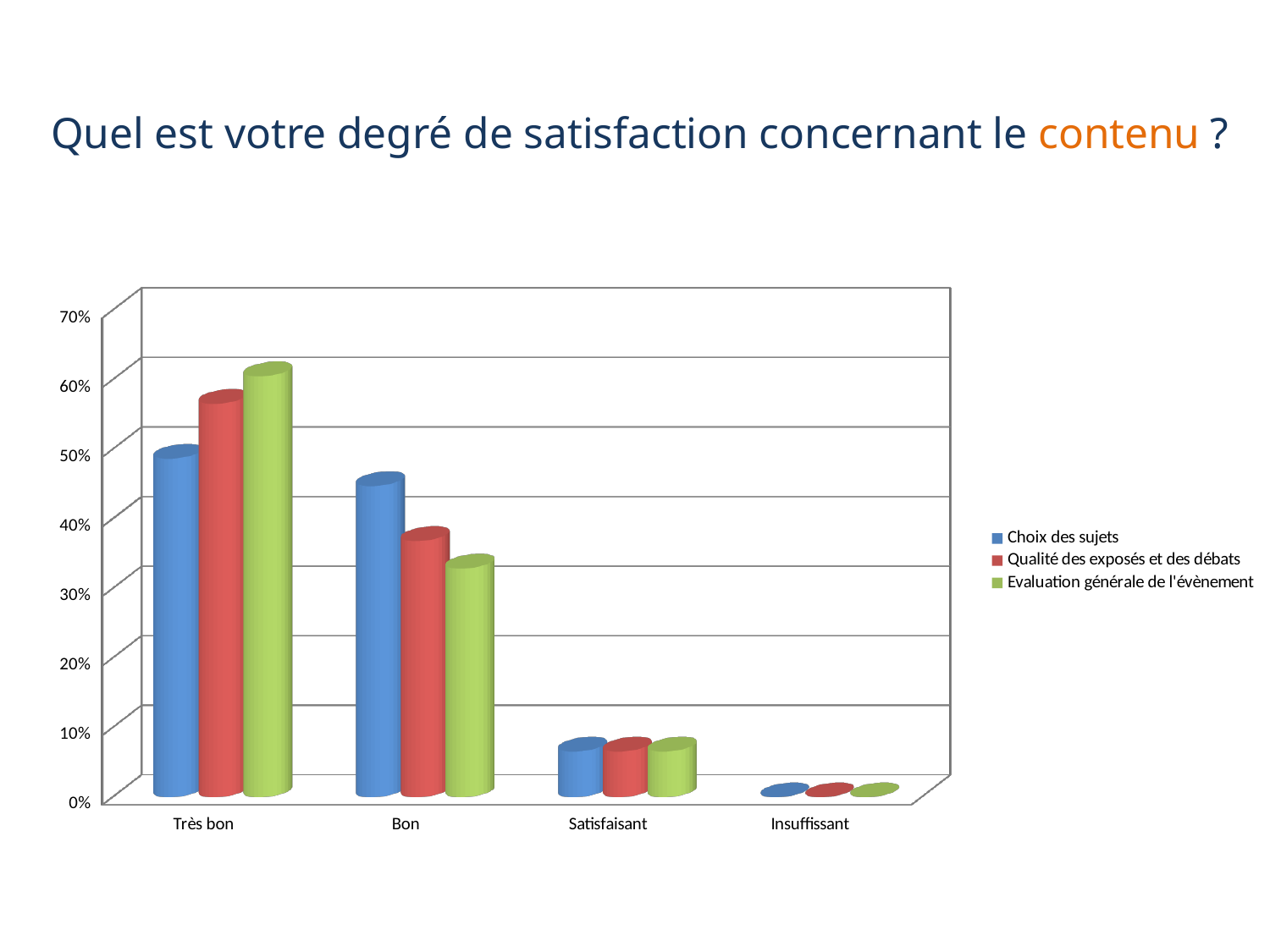
Do the values for Evaluation générale de l'évènement rise or fall from Très bon to Insuffissant along the x axis? fall How many categories are shown on the x axis of the chart? 4 Is the value for Choix des sujets in the Satisfaisant category greater or less than 10%? less For the Qualité des exposés et des débats series, which category has the lowest value? Insuffissant Is the value for Evaluation générale de l'évènement in the Bon category greater or less than 40%? less Is the value for Choix des sujets in the Très bon category greater or less than 40%? greater Which series is shown in green in the chart legend? Evaluation générale de l'évènement In the Très bon category, which is larger: Choix des sujets or Evaluation générale de l'évènement? Evaluation générale de l'évènement How many series does the chart legend list? 3 What kind of chart is shown on the slide? bar chart For the Evaluation générale de l'évènement series, which category has the highest value? Très bon